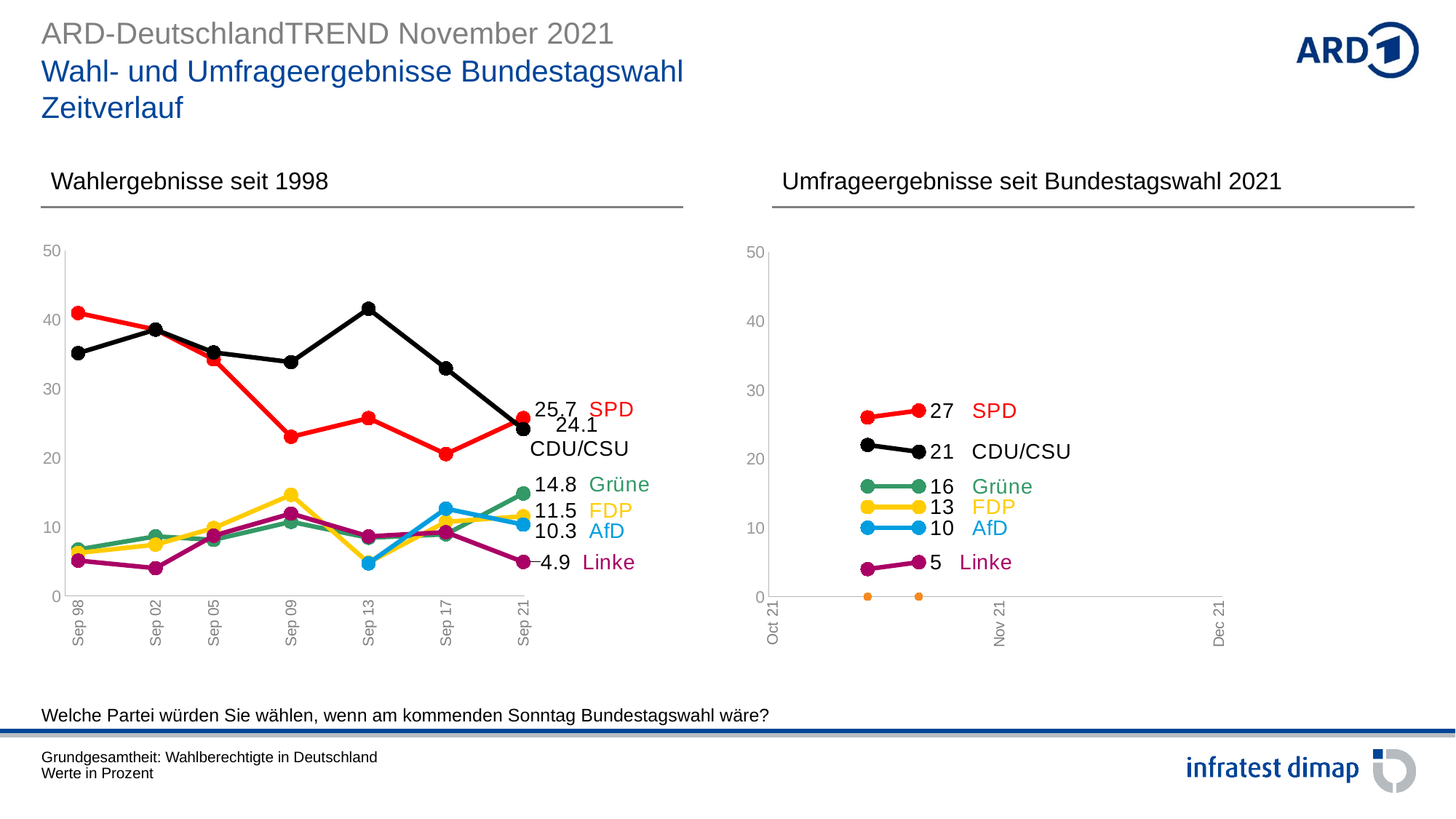
In the chart 'Wahlergebnisse seit 1998', what is the value for SPD at Sep 21? 25.7 What kind of chart is 'Umfrageergebnisse seit Bundestagswahl 2021'? line chart In the chart 'Wahlergebnisse seit 1998', what is the value for CDU/CSU at Sep 21? 24.1 In the chart 'Wahlergebnisse seit 1998', does the CDU/CSU line rise or fall between Sep 13 and Sep 21? fall In the chart 'Wahlergebnisse seit 1998', what is the difference between the Sep 21 values for Grüne and FDP? 3.3 In the chart 'Wahlergebnisse seit 1998', how many election dates are shown on the x axis? 7 In the chart 'Umfrageergebnisse seit Bundestagswahl 2021', what is the latest value for SPD? 27 In the chart 'Umfrageergebnisse seit Bundestagswahl 2021', which has the larger latest value, Grüne or FDP? Grüne In the chart 'Umfrageergebnisse seit Bundestagswahl 2021', which party has the lowest latest value? Linke In the chart 'Umfrageergebnisse seit Bundestagswahl 2021', what is the difference between the latest values for SPD and CDU/CSU? 6 In the chart 'Wahlergebnisse seit 1998', is the value for SPD at Sep 98 greater or less than 40? greater In the chart 'Wahlergebnisse seit 1998', what is the value for Linke at Sep 21? 4.9